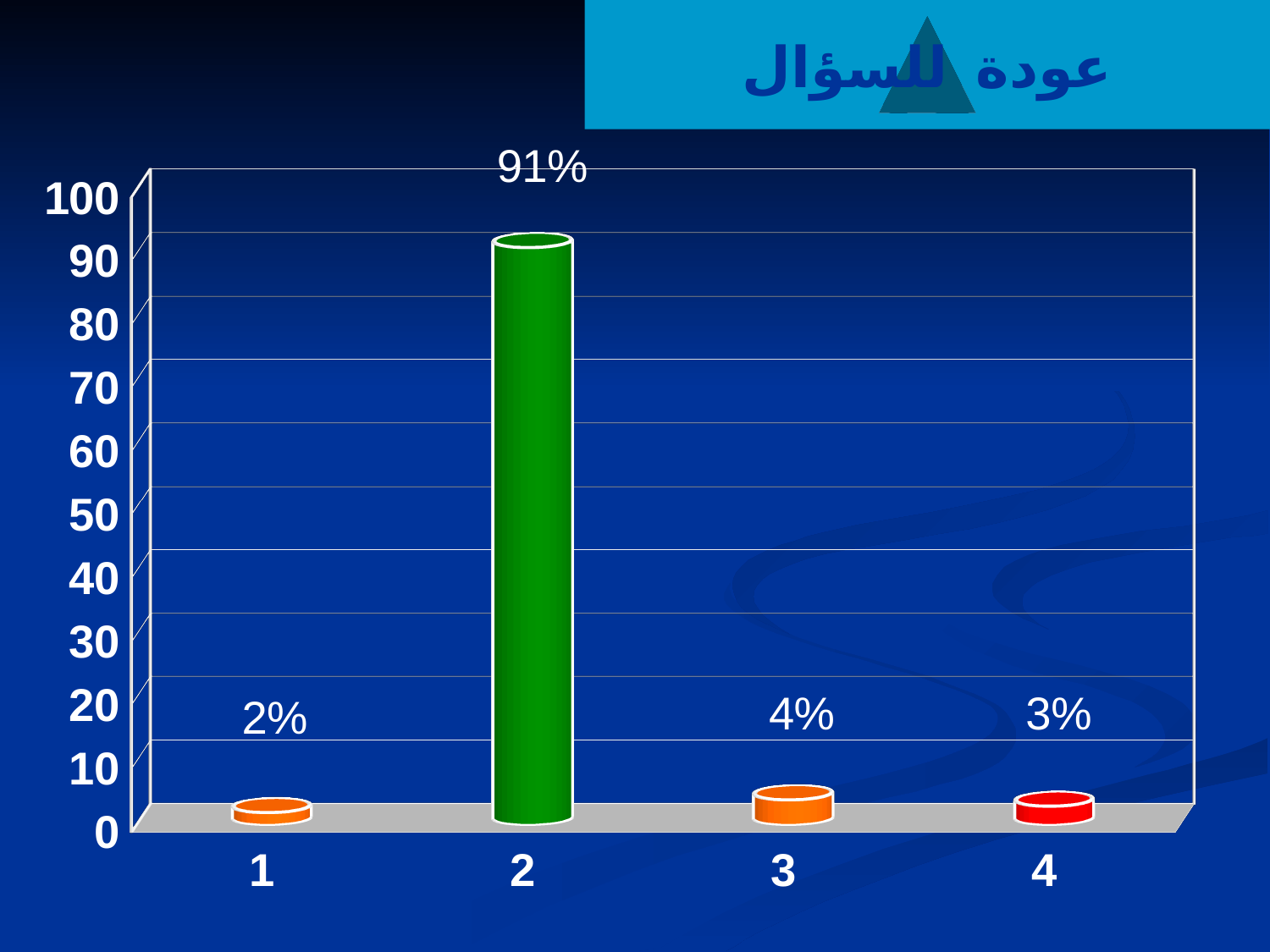
Which is larger, the value for category 3 or the value for category 4? 3 How many categories are shown on the x axis? 4 Is the value for category 2 greater or less than 90? greater Which category has the highest value? 2 What is the difference between the values for category 2 and category 3? 87% Which category has the lowest value? 1 What is the value for category 3? 4% What is the value for category 2? 91% What is the difference between the values for category 3 and category 1? 2% What kind of chart is shown on the slide? bar chart What is the value for category 4? 3% What is the value for category 1? 2%